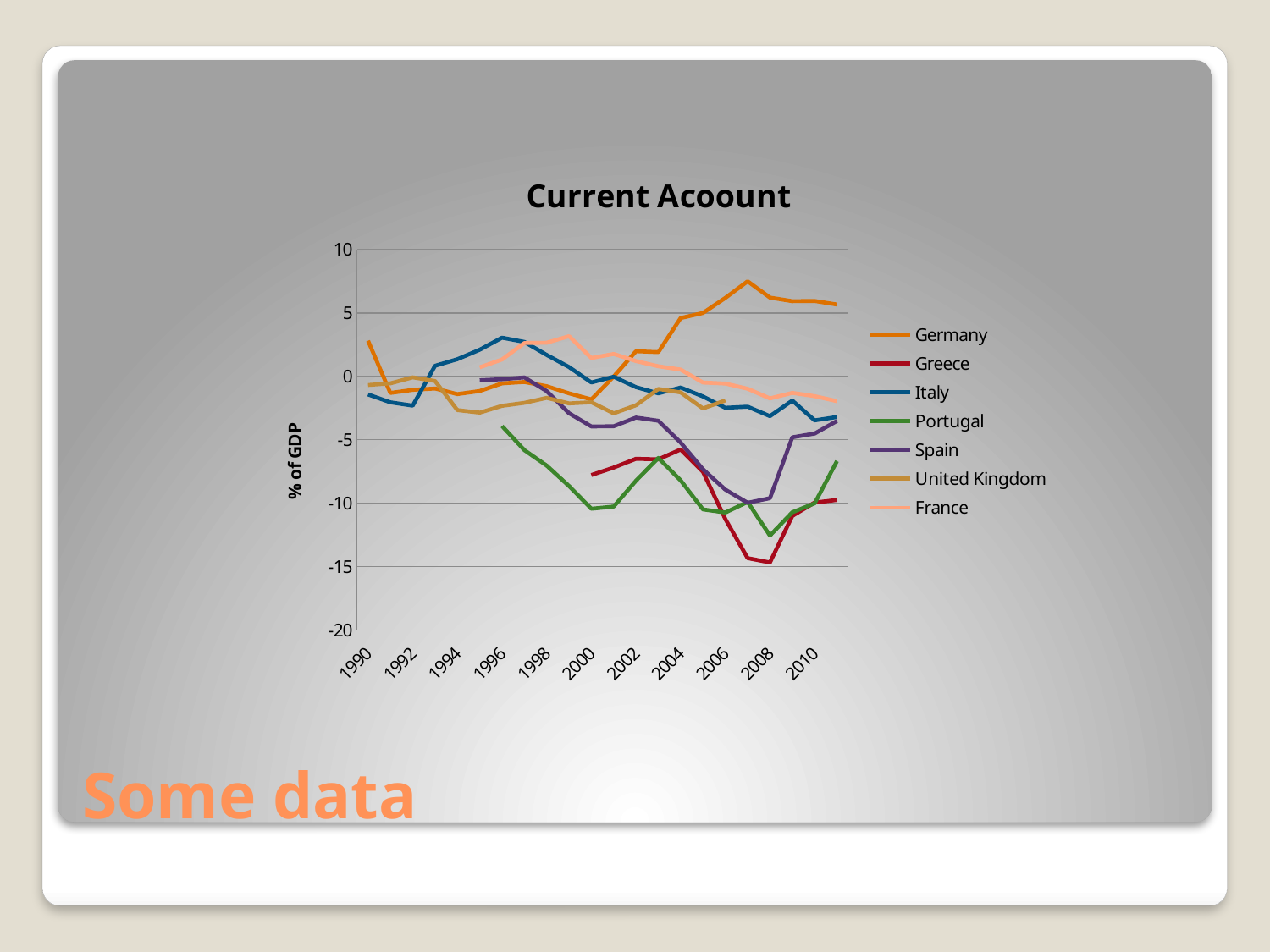
Which country's line reaches the lowest value on the chart? Greece Does the Greece line rise or fall between 2004 and 2008? fall Is the value for Italy in 2010 greater or less than 0? less How many series does the legend of the Current Acoount chart list? 7 What is the title of the chart? Current Acoount What kind of chart is shown on the slide? line chart Is the value for Germany in 2008 greater or less than 5? greater What is the label on the vertical axis of the chart? % of GDP Which country's line reaches the highest value on the chart? Germany Is the value for Greece in 2008 greater or less than -10? less Does the Germany line rise or fall between 2000 and 2007? rise